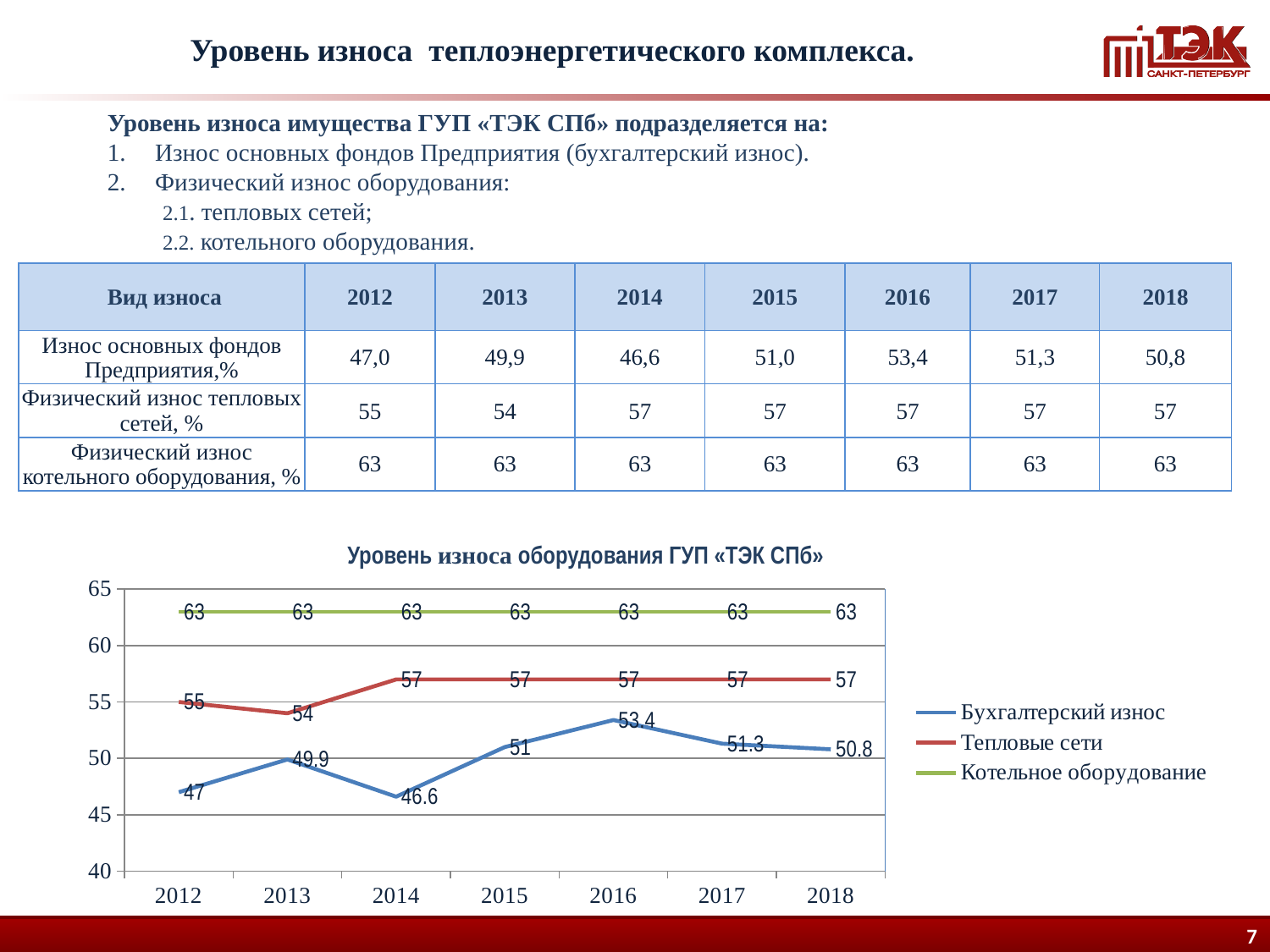
What is the value of Котельное оборудование in 2018? 63 In which year is Бухгалтерский износ at its highest? 2016 How many years are shown on the x axis of the chart? 7 What is the value of Бухгалтерский износ in 2016? 53.4 What is the title of the chart on the slide? Уровень износа оборудования ГУП «ТЭК СПб» What is the value of Тепловые сети in 2013? 54 How many series does the chart legend list? 3 Does the Котельное оборудование series rise, fall or stay flat from 2012 to 2018? Stays flat What type of chart is shown on the slide? Line chart Which series has the larger value in 2012: Тепловые сети or Бухгалтерский износ? Тепловые сети In which year is Бухгалтерский износ at its lowest? 2014 What is the difference between Тепловые сети in 2014 and in 2013? 3